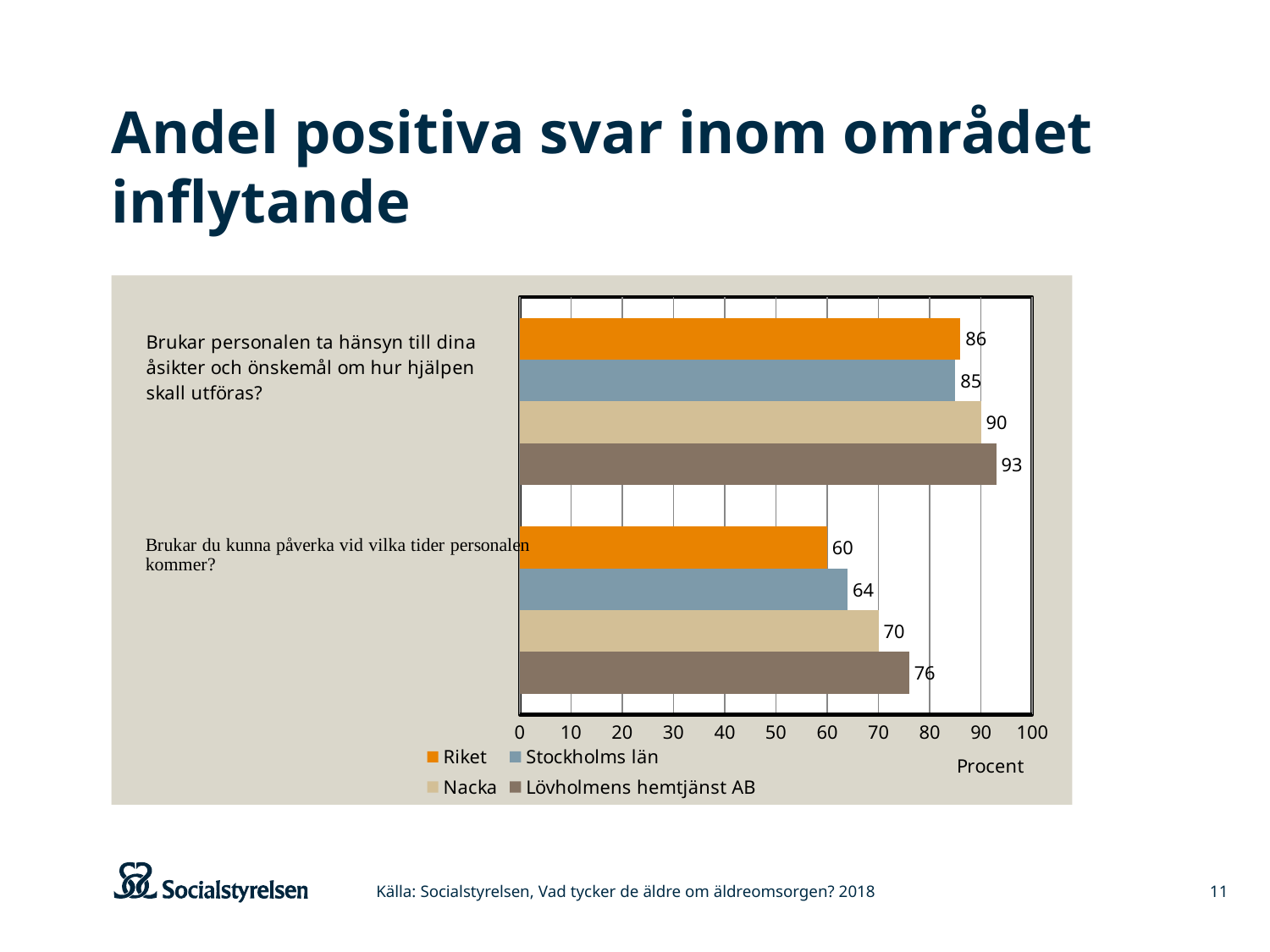
What kind of chart is shown on the slide? Bar chart What is the value for Riket on the question "Brukar du kunna påverka vid vilka tider personalen kommer?"? 60 What is the value for Nacka on the question "Brukar du kunna påverka vid vilka tider personalen kommer?"? 70 What is the difference between Lövholmens hemtjänst AB and Riket on the question "Brukar du kunna påverka vid vilka tider personalen kommer?"? 16 What is the label of the horizontal axis? Procent What is the value for Stockholms län on the question "Brukar personalen ta hänsyn till dina åsikter och önskemål om hur hjälpen skall utföras?"? 85 How many series does the legend list? 4 Which series has the highest value on the question "Brukar du kunna påverka vid vilka tider personalen kommer?"? Lövholmens hemtjänst AB Which is larger on the question "Brukar personalen ta hänsyn till dina åsikter och önskemål om hur hjälpen skall utföras?": Nacka or Riket? Nacka What is the value for Lövholmens hemtjänst AB on the question "Brukar personalen ta hänsyn till dina åsikter och önskemål om hur hjälpen skall utföras?"? 93 How many questions (categories) are shown on the chart? 2 Which series has the lowest value on the question "Brukar personalen ta hänsyn till dina åsikter och önskemål om hur hjälpen skall utföras?"? Stockholms län